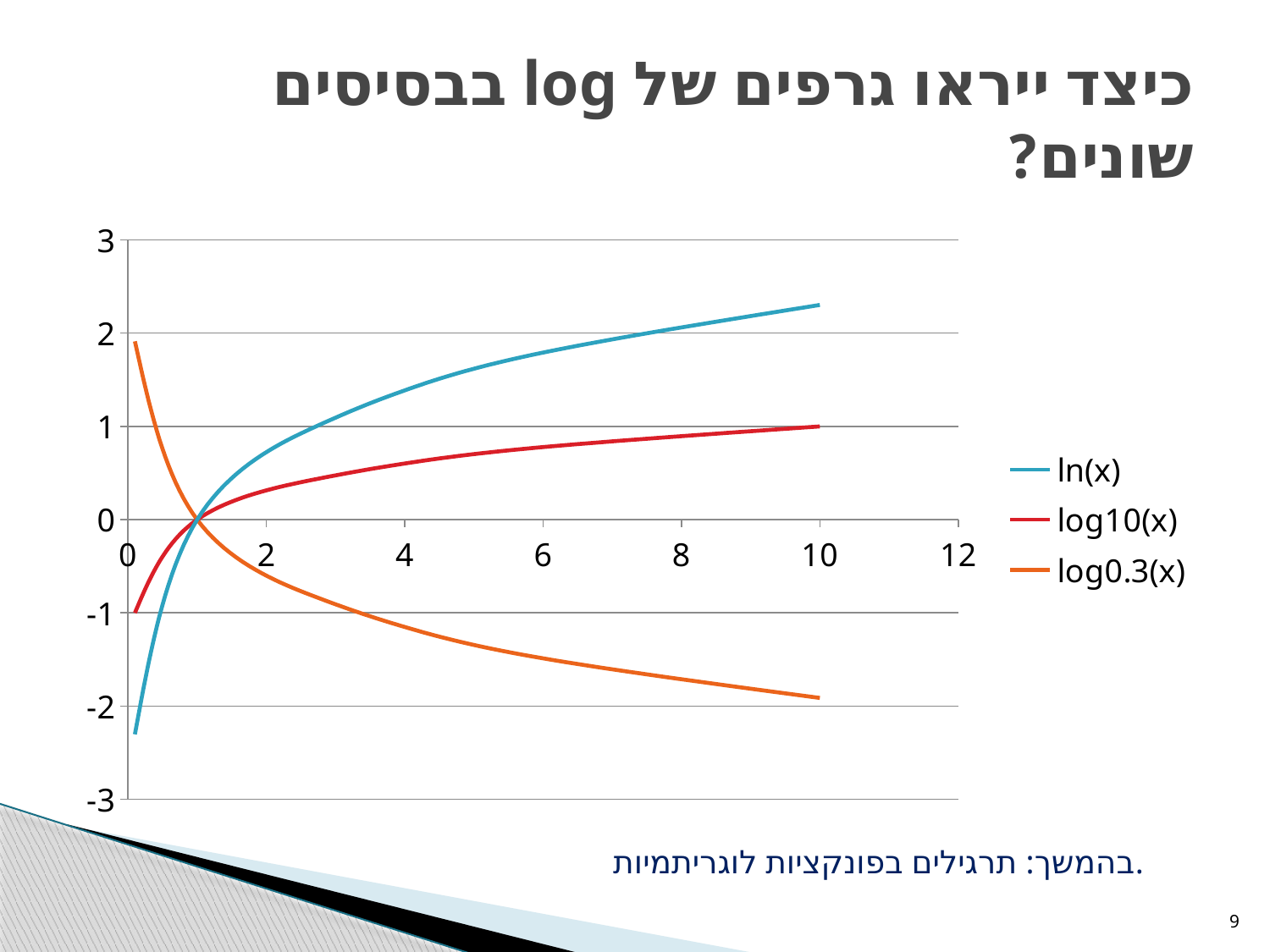
What colour is the ln(x) line? blue At x = 10, which series has the lowest value? log0.3(x) Which series are listed in the legend? ln(x), log10(x), log0.3(x) Is the value of ln(x) at x = 10 greater or less than 2? greater Is the value of log0.3(x) at x = 10 greater or less than -1? less What kind of chart is shown on the slide? line chart Does the log0.3(x) line rise or fall as x increases? fall Does the ln(x) line rise or fall as x increases? rise Is the value of log10(x) at x = 2 greater or less than 1? less How many series does the legend list? 3 What is the value of log10(x) at x = 10? 1 At x = 10, which series has the highest value? ln(x)